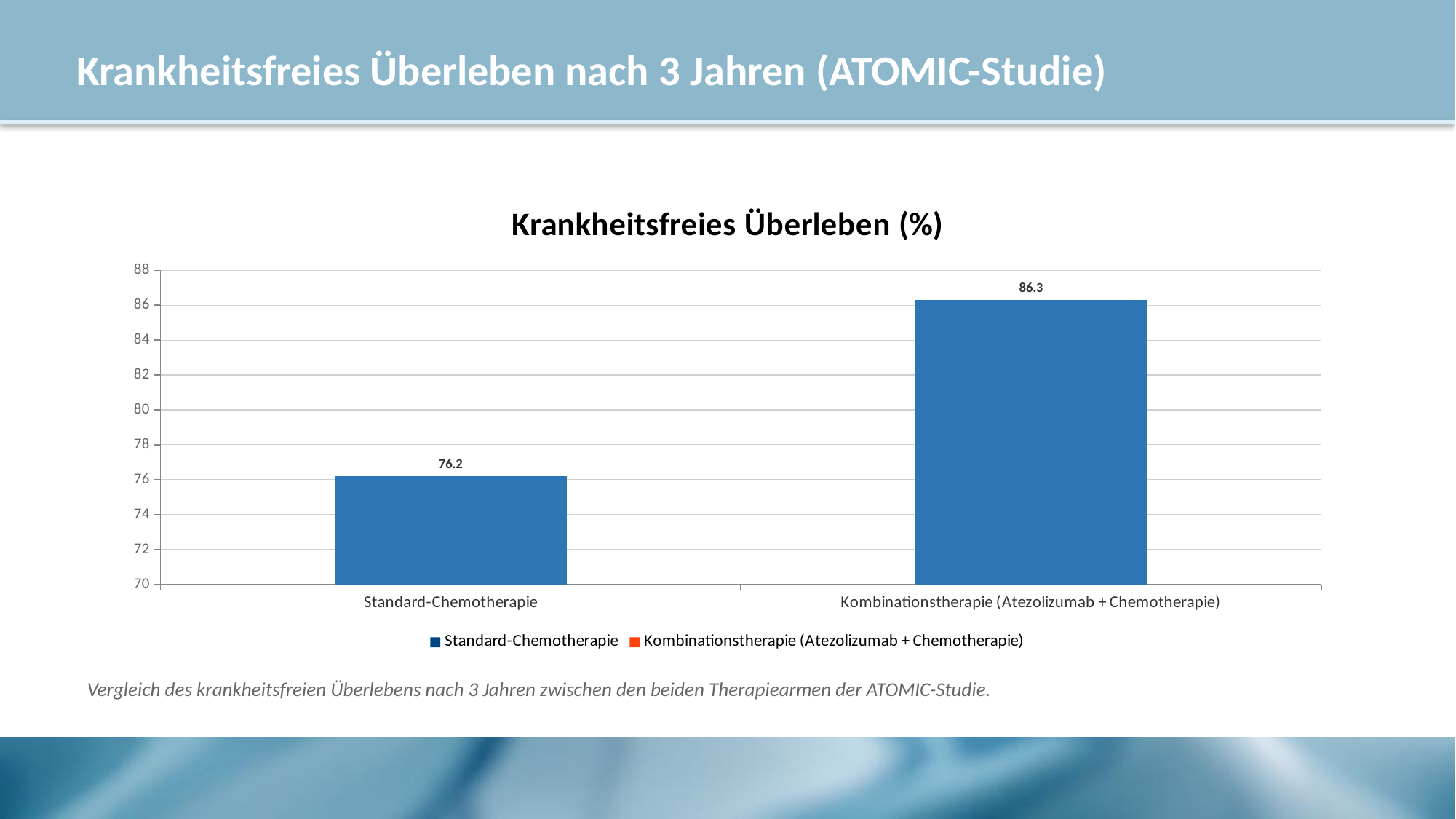
What is the value for Standard-Chemotherapie? 76.2 Is the value for Standard-Chemotherapie greater or less than 80? less Which is larger, the value for Standard-Chemotherapie or the value for Kombinationstherapie (Atezolizumab + Chemotherapie)? Kombinationstherapie (Atezolizumab + Chemotherapie) How many series does the legend list? 2 What kind of chart is shown on the slide? bar chart How many categories are shown on the x axis? 2 What is the title of the chart? Krankheitsfreies Überleben (%) Is the value for Kombinationstherapie (Atezolizumab + Chemotherapie) greater or less than 84? greater What is the value for Kombinationstherapie (Atezolizumab + Chemotherapie)? 86.3 Which category has the lowest value? Standard-Chemotherapie What is the difference between the values for Kombinationstherapie (Atezolizumab + Chemotherapie) and Standard-Chemotherapie? 10.1 Which category has the highest value? Kombinationstherapie (Atezolizumab + Chemotherapie)